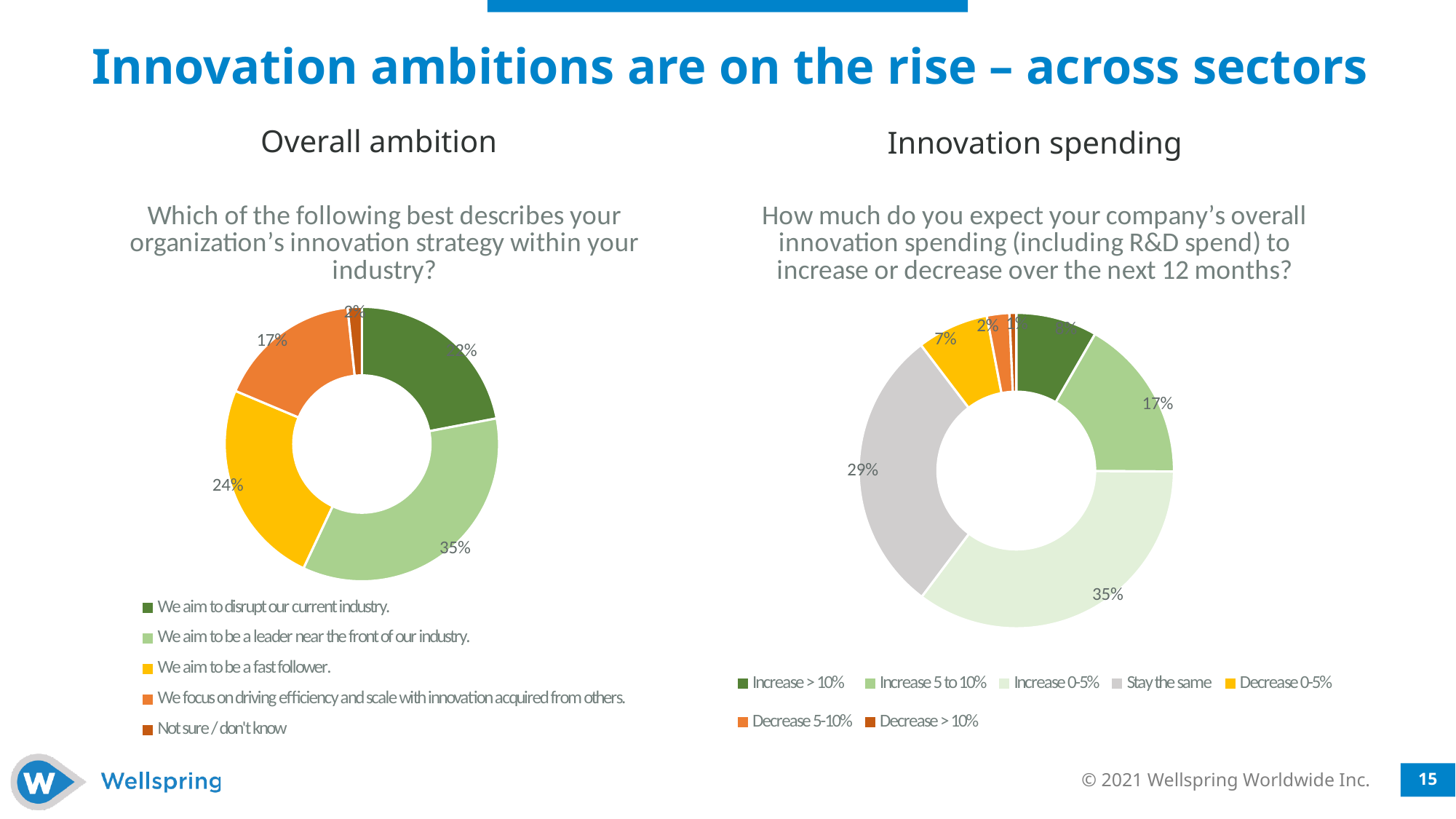
In the Overall ambition chart, what is the difference between the share for "We aim to be a leader near the front of our industry" and "We aim to be a fast follower"? 11 percentage points In the Overall ambition chart, which response has the smallest share? Not sure / don't know In the Overall ambition chart, what percentage of respondents chose "We aim to be a leader near the front of our industry"? 35% What kind of chart is the Overall ambition chart on the left? Pie chart (donut) In the Innovation spending chart, what percentage expect a decrease of 0-5%? 7% In the Overall ambition chart, what percentage chose "We aim to be a fast follower"? 24% In the Overall ambition chart, how many response categories does the legend list? 5 In the Innovation spending chart, which is larger: the share for "Stay the same" or the share for "Increase 5 to 10%"? Stay the same In the Innovation spending chart, what percentage expect an increase of 0-5%? 35% In the Innovation spending chart, what percentage of respondents expect spending to stay the same? 29% In the Innovation spending chart, how many categories does the legend list? 7 In the Overall ambition chart, what percentage chose "We focus on driving efficiency and scale with innovation acquired from others"? 17%